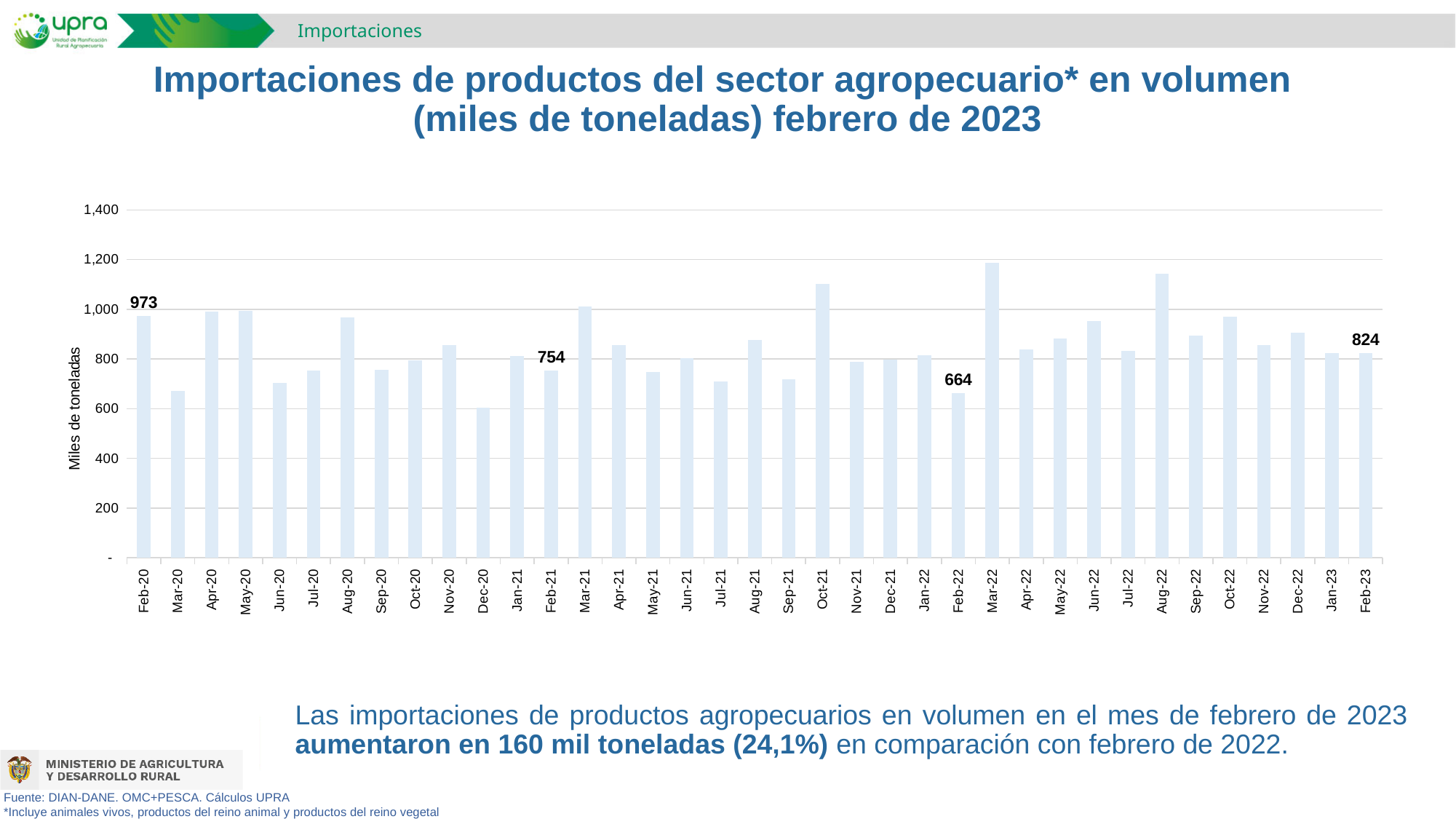
What kind of chart is shown on the slide? bar chart What is the value for Feb-21? 754 Which month has the lowest value in the chart? Dec-20 Which month has the highest value in the chart? Mar-22 How many months (bars) are shown in the chart? 37 What is the value for Feb-20? 973 Which is larger, the value for Feb-20 or the value for Feb-23? Feb-20 What is the difference between the values for Feb-23 and Feb-22? 160 What is the value for Feb-23? 824 Is the value for Mar-20 greater or less than 800? less Is the value for Oct-21 greater or less than 1,000? greater What is the value for Feb-22? 664